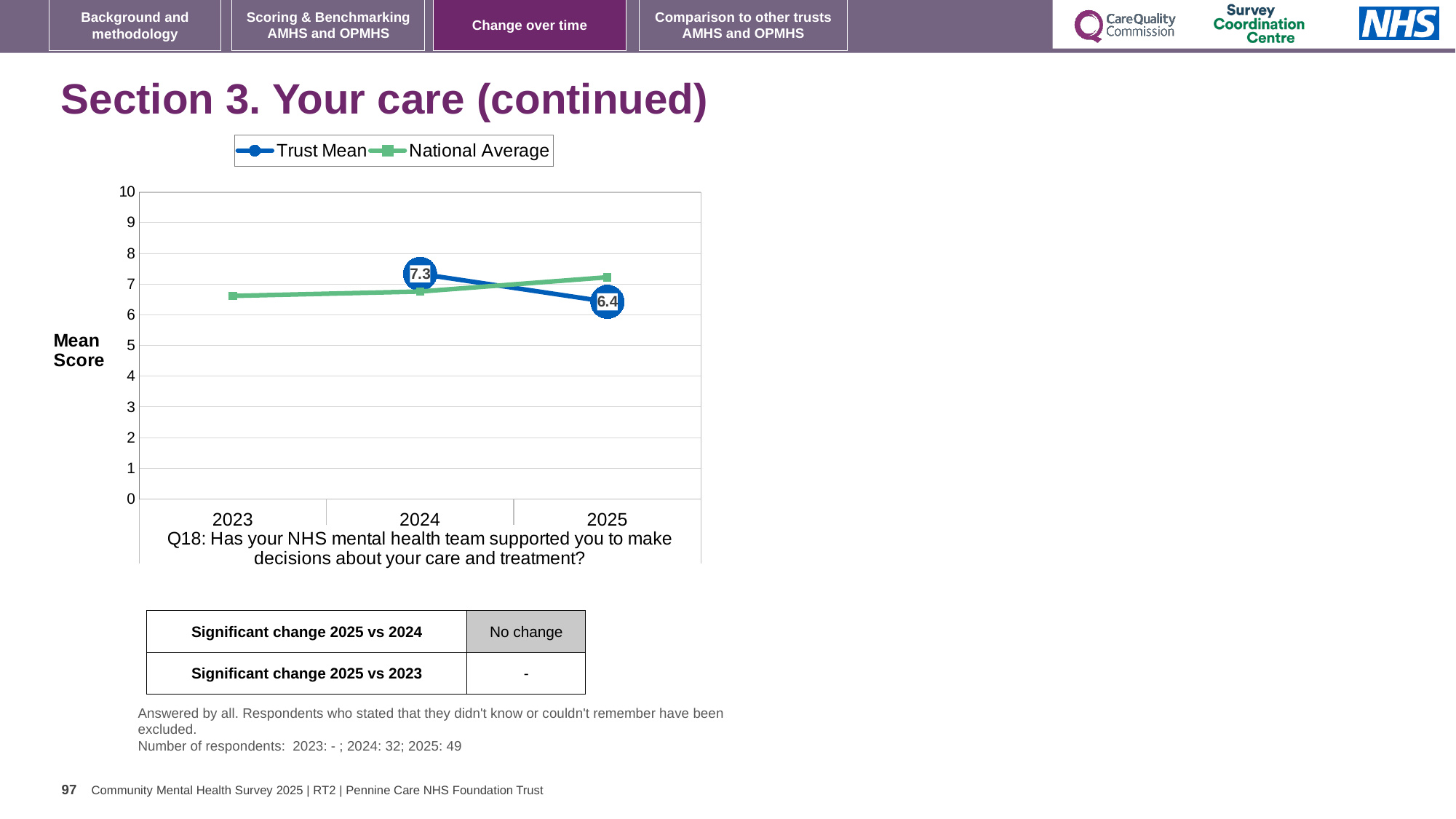
What kind of chart is shown on the slide? line chart What is the label on the y axis of the chart? Mean Score Does the Trust Mean rise or fall from 2024 to 2025? fall What is the Trust Mean value for 2024? 7.3 Which year has the higher Trust Mean, 2024 or 2025? 2024 Is the National Average value for 2023 greater or less than 7? less What is the Trust Mean value for 2025? 6.4 Does the National Average rise or fall from 2023 to 2025? rise How many series does the legend list? 2 In 2025, which series is higher, Trust Mean or National Average? National Average What is the difference between the Trust Mean in 2024 and in 2025? 0.9 How many years are shown on the x axis? 3